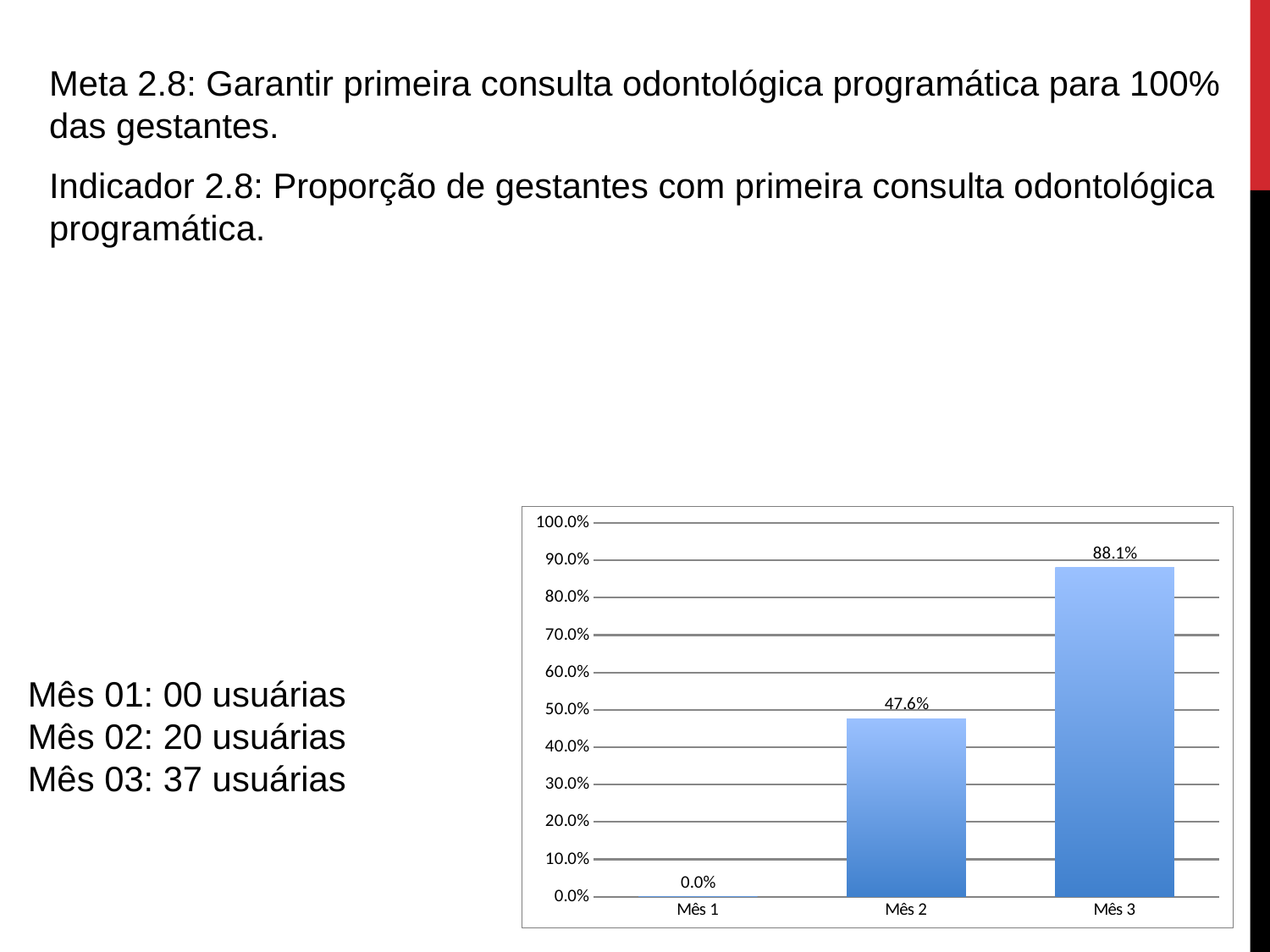
Is the value for Mês 2 greater or less than 50.0%? less Which month has the highest value? Mês 3 What is the value for Mês 3? 88.1% Is the value for Mês 3 greater or less than 80.0%? greater Which month has the lowest value? Mês 1 How many categories are shown on the x axis? 3 Which is larger, the value for Mês 2 or the value for Mês 3? Mês 3 What kind of chart is shown on the slide? bar chart Do the values rise or fall from Mês 1 to Mês 3? rise What is the value for Mês 2? 47.6% What is the difference between the values for Mês 3 and Mês 2? 40.5% What is the value for Mês 1? 0.0%